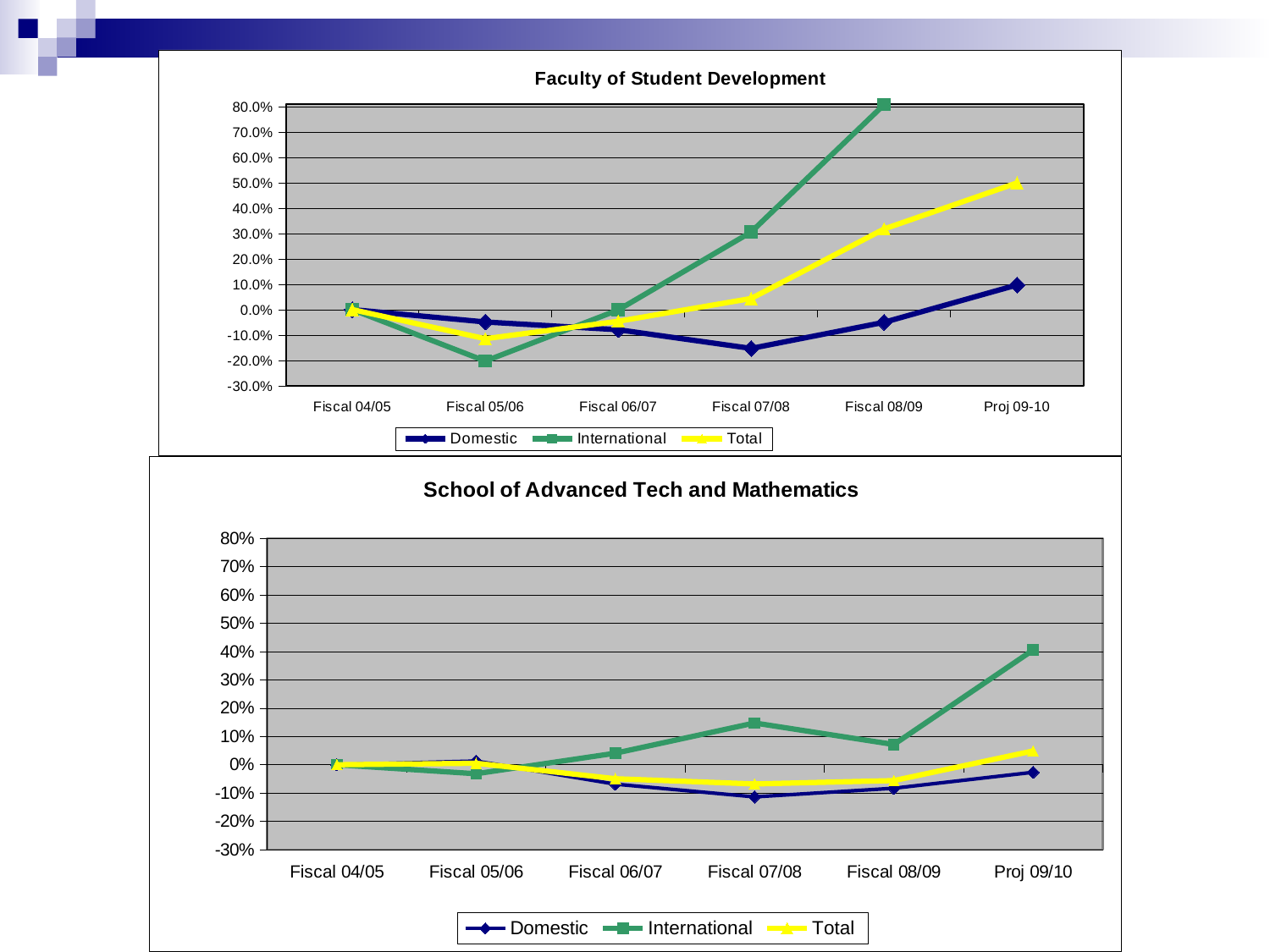
What is the title of the lower chart on the slide? School of Advanced Tech and Mathematics In the Faculty of Student Development chart, at Fiscal 05/06, which is larger: Domestic or International? Domestic How many fiscal periods are shown on the x axis of the Faculty of Student Development chart? 6 In the Faculty of Student Development chart, which series has the highest value at Fiscal 08/09? International In the School of Advanced Tech and Mathematics chart, does the International line rise or fall from Fiscal 08/09 to Proj 09/10? rise In the Faculty of Student Development chart, is the Domestic value for Fiscal 07/08 greater or less than -10.0%? less In the Faculty of Student Development chart, is the International value for Fiscal 07/08 greater or less than 20.0%? greater In the Faculty of Student Development chart, is the Total value for Proj 09-10 greater or less than 40.0%? greater What kind of chart is the Faculty of Student Development chart? line chart In the School of Advanced Tech and Mathematics chart, which series has the lowest value at Proj 09/10? Domestic How many series does the legend of the School of Advanced Tech and Mathematics chart list? 3